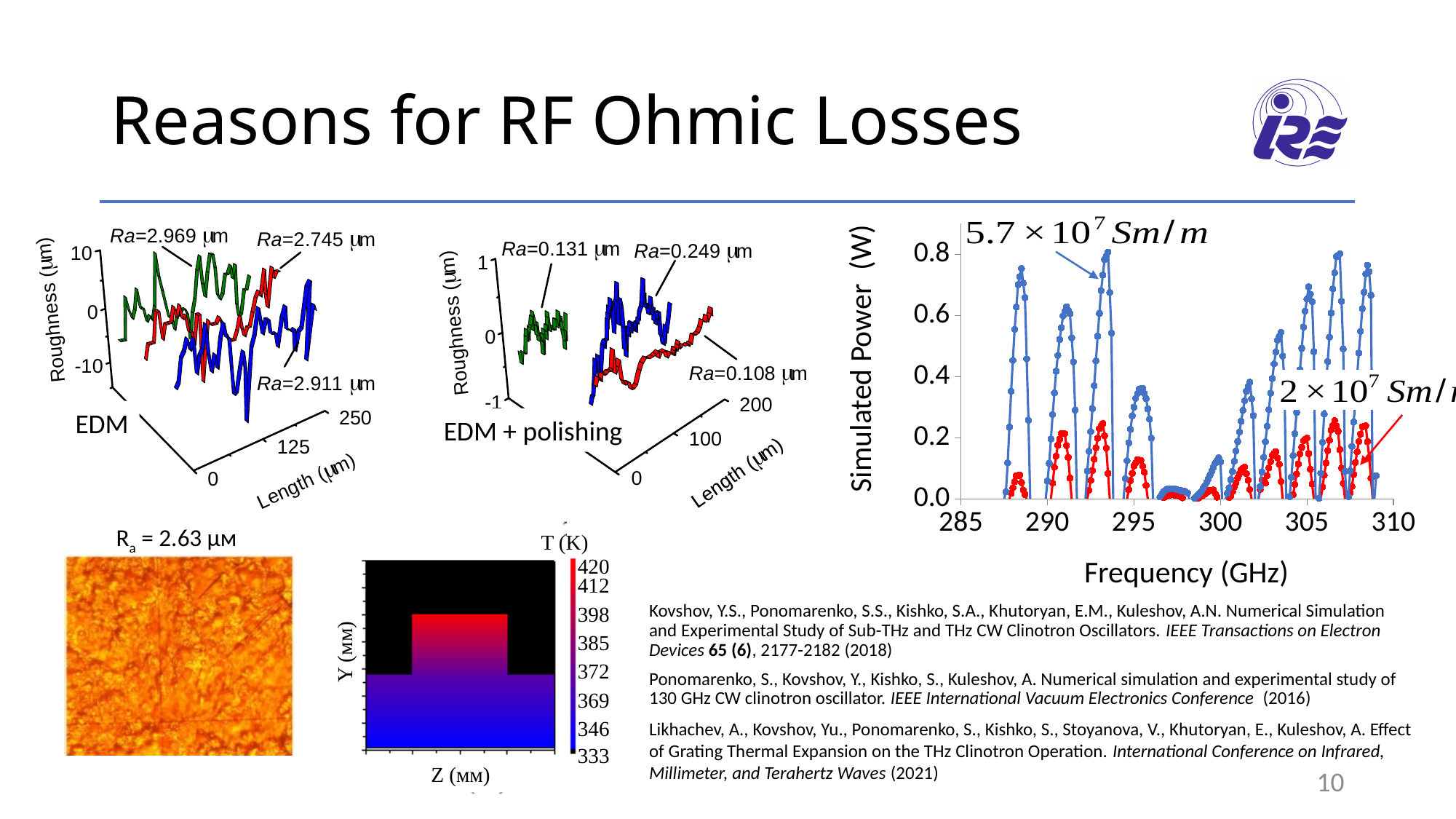
In the EDM + polishing roughness chart, what is the lowest Ra value labelled? Ra=0.108 µm How many roughness traces are plotted in the EDM roughness chart? 3 In the Simulated Power versus Frequency chart, which conductivity series reaches higher power values, 5.7×10^7 Sm/m or 2×10^7 Sm/m? 5.7×10^7 Sm/m In the Simulated Power versus Frequency chart, what is the highest tick value shown on the Frequency axis? 310 What kind of chart is the Simulated Power versus Frequency chart on the right of the slide? line chart In the temperature map at the bottom of the slide, what is the maximum value shown on the T (K) colour scale? 420 In the Simulated Power versus Frequency chart, is the highest value of the red (2×10^7 Sm/m) series greater or less than 0.4 W? less In the EDM + polishing roughness chart, what is the highest Ra value labelled? Ra=0.249 µm In the Simulated Power versus Frequency chart, is the highest value of the blue (5.7×10^7 Sm/m) series greater or less than 0.6 W? greater In the EDM roughness chart, what is the lowest Ra value labelled? Ra=2.745 µm In the EDM roughness chart, what is the highest Ra value labelled? Ra=2.969 µm In the Simulated Power versus Frequency chart, what is the label of the x axis? Frequency (GHz)